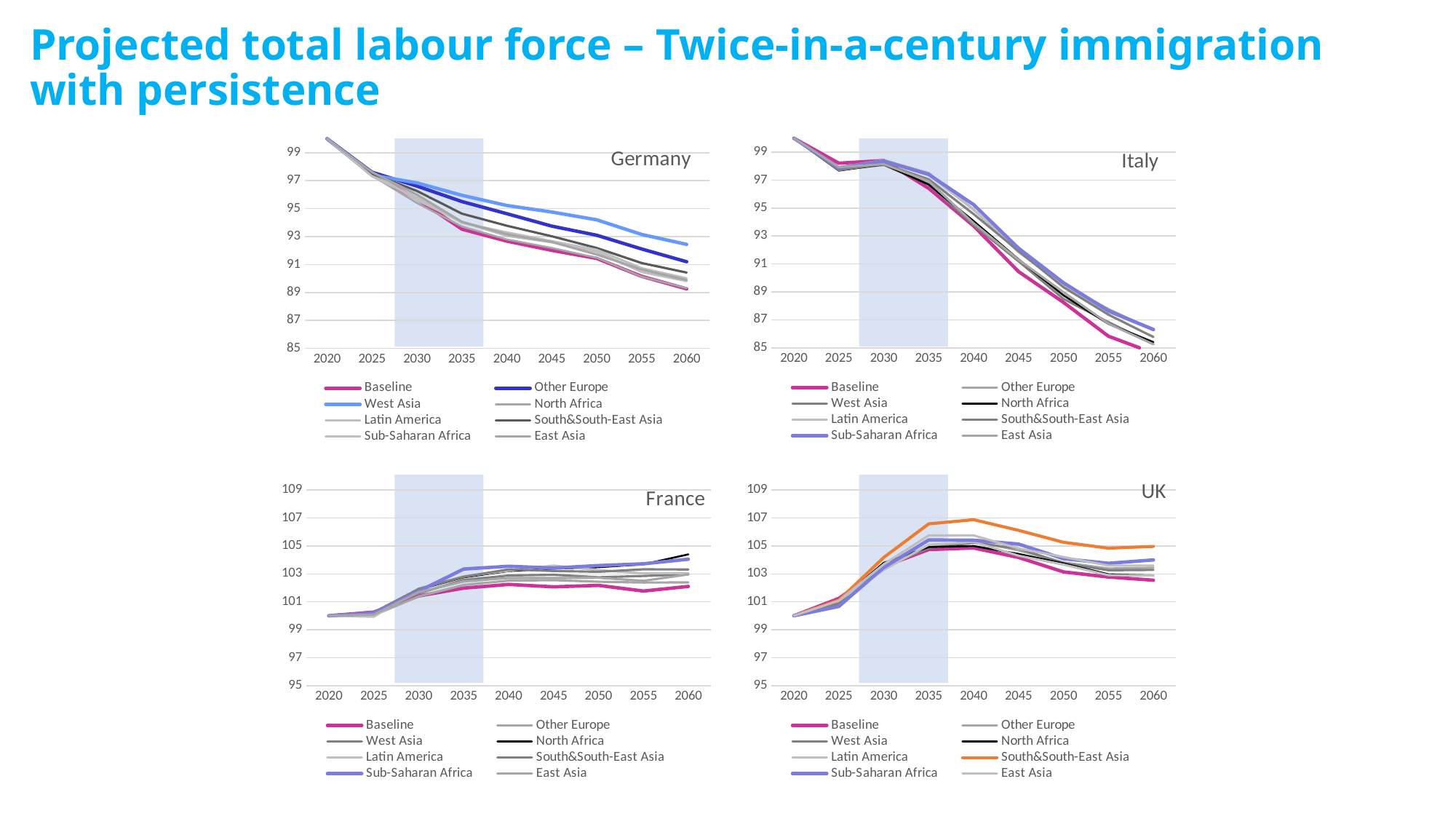
In the Italy chart, do the values generally rise or fall from 2020 to 2060? fall What kind of chart is the Germany chart? line chart How many years are labelled on the x axis of the France chart? 9 In the Germany chart, which series is highest in 2060? West Asia In the UK chart, which series is highest in 2040? South&South-East Asia How many series does the legend of the Italy chart list? 8 In the Germany chart, is the value for West Asia in 2060 greater or less than 91? greater In the UK chart, is the value for South&South-East Asia in 2040 greater or less than 105? greater In the UK chart, what colour is the South&South-East Asia line? orange In the UK chart, does the Baseline series rise or fall from 2020 to 2035? rise In the Italy chart, which series is lowest in 2060? Baseline